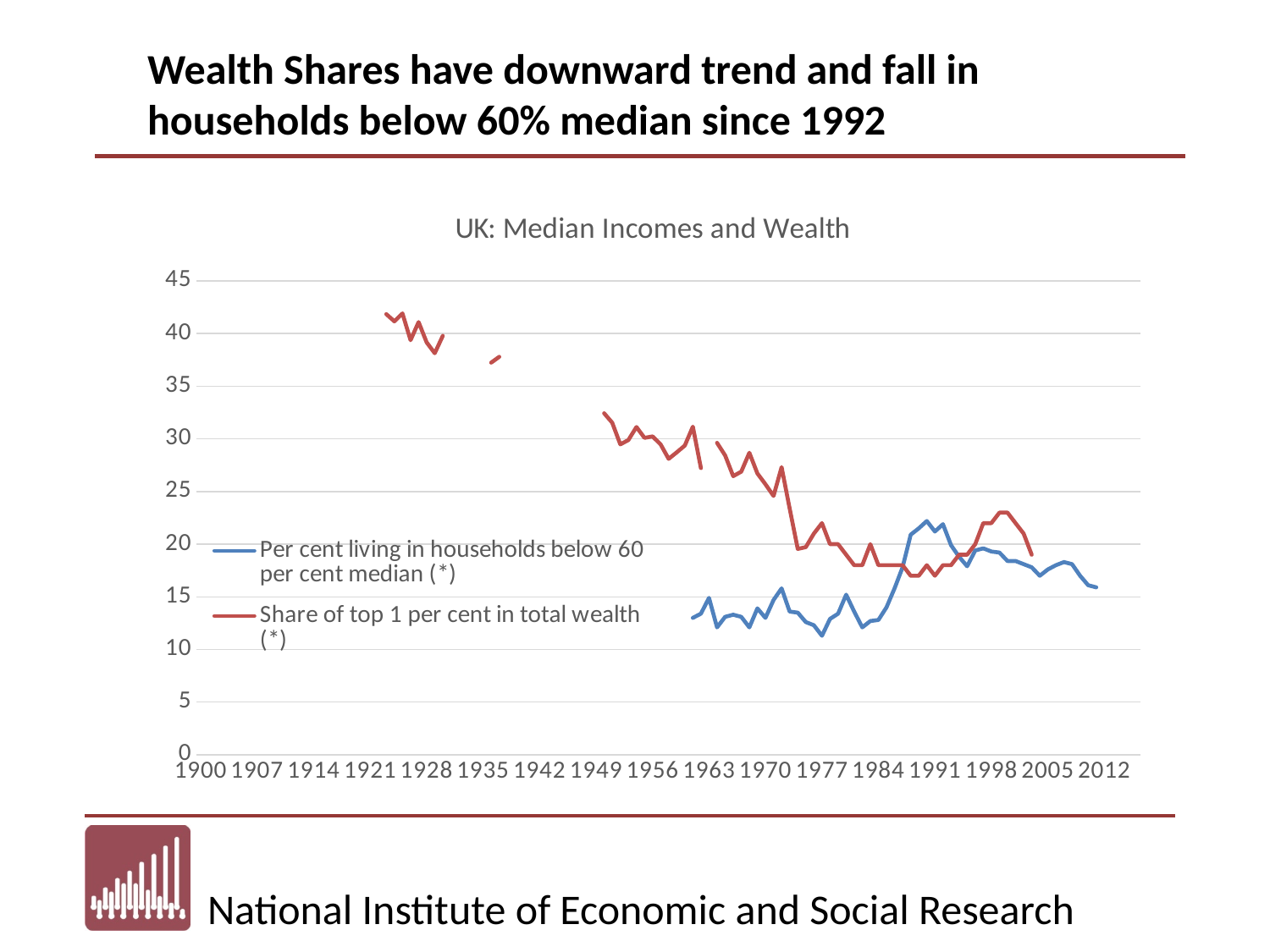
Which colour is used for the 'Share of top 1 per cent in total wealth (*)' series? red Is the value of 'Share of top 1 per cent in total wealth (*)' in 1977 greater or less than 25? less What kind of chart is shown on the slide? line chart How many series does the legend list? 2 Is the value of 'Per cent living in households below 60 per cent median (*)' in 1991 greater or less than 20? greater What is the title of the chart? UK: Median Incomes and Wealth Which series reaches the highest value on the chart? Share of top 1 per cent in total wealth (*) Is the value of 'Per cent living in households below 60 per cent median (*)' in 1977 greater or less than 15? less In 1963, which series has the larger value: 'Share of top 1 per cent in total wealth (*)' or 'Per cent living in households below 60 per cent median (*)'? Share of top 1 per cent in total wealth (*) Does the 'Share of top 1 per cent in total wealth (*)' series rise or fall overall from 1921 to 2005? fall